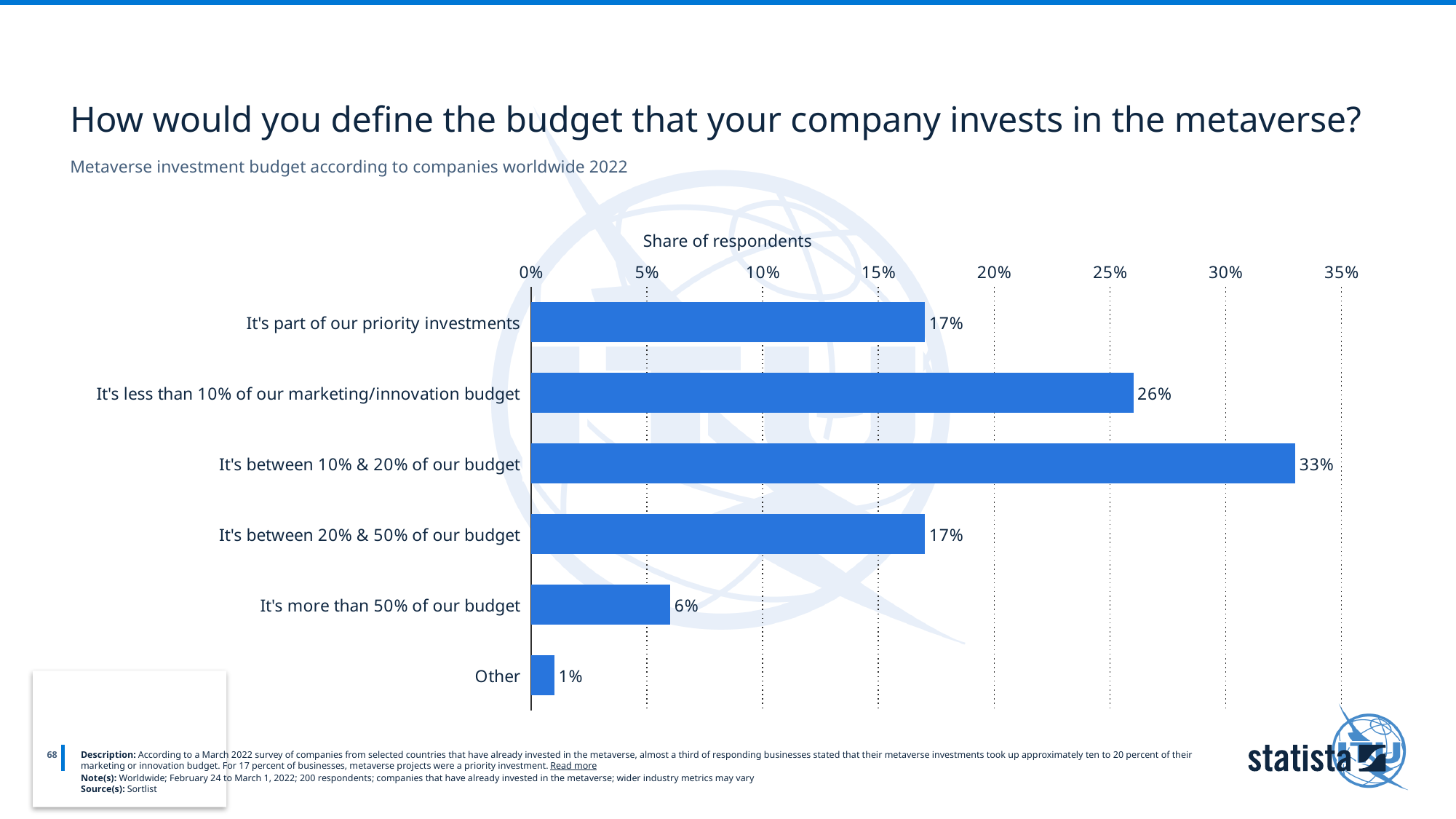
What share of respondents said it's less than 10% of their marketing/innovation budget? 26% What kind of chart is shown on the slide? Bar chart What share of respondents answered 'Other'? 1% How many categories are shown in the chart? 6 What share of respondents said it's more than 50% of their budget? 6% Which category has the lowest share of respondents? Other Is the value for 'It's less than 10% of our marketing/innovation budget' greater or less than 25%? greater What is the label of the horizontal axis? Share of respondents What is the difference in share of respondents between 'It's between 10% & 20% of our budget' and 'It's less than 10% of our marketing/innovation budget'? 7% Which is larger: the share for 'It's part of our priority investments' or the share for 'It's more than 50% of our budget'? It's part of our priority investments Which category has the highest share of respondents? It's between 10% & 20% of our budget What share of respondents said the metaverse budget is between 10% & 20% of their budget? 33%